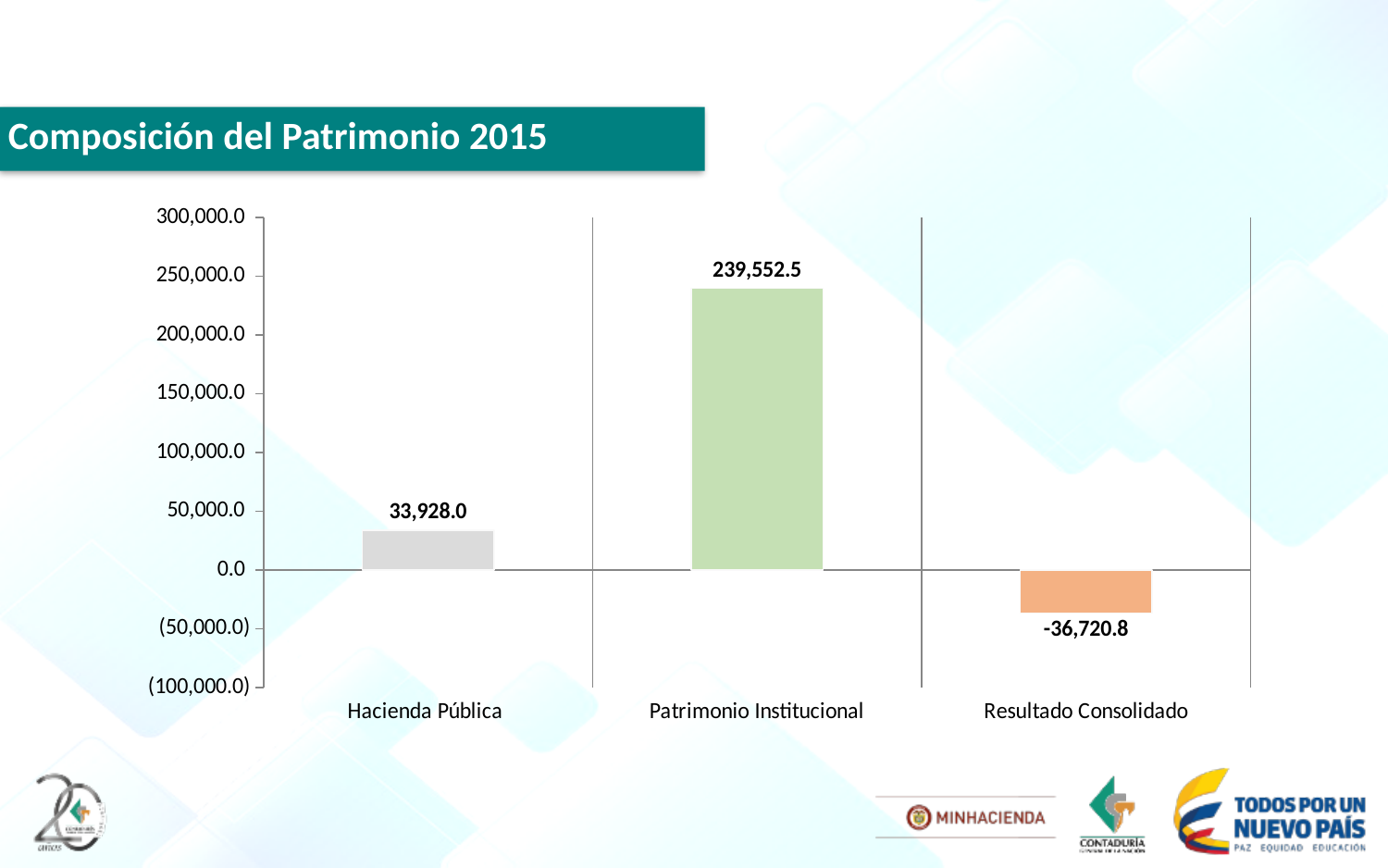
Is the value for Patrimonio Institucional greater or less than 200,000.0? greater What is the value for Resultado Consolidado? -36,720.8 What kind of chart is shown on the slide? Bar chart Which is larger, the value for Hacienda Pública or the value for Resultado Consolidado? Hacienda Pública Which category has the lowest value? Resultado Consolidado Is the value for Hacienda Pública greater or less than 50,000.0? less What is the value for Hacienda Pública? 33,928.0 What is the value for Patrimonio Institucional? 239,552.5 How many categories are shown on the chart? 3 What is the difference between the values for Patrimonio Institucional and Hacienda Pública? 205,624.5 Which category has the highest value? Patrimonio Institucional What is the title of the chart? Composición del Patrimonio 2015